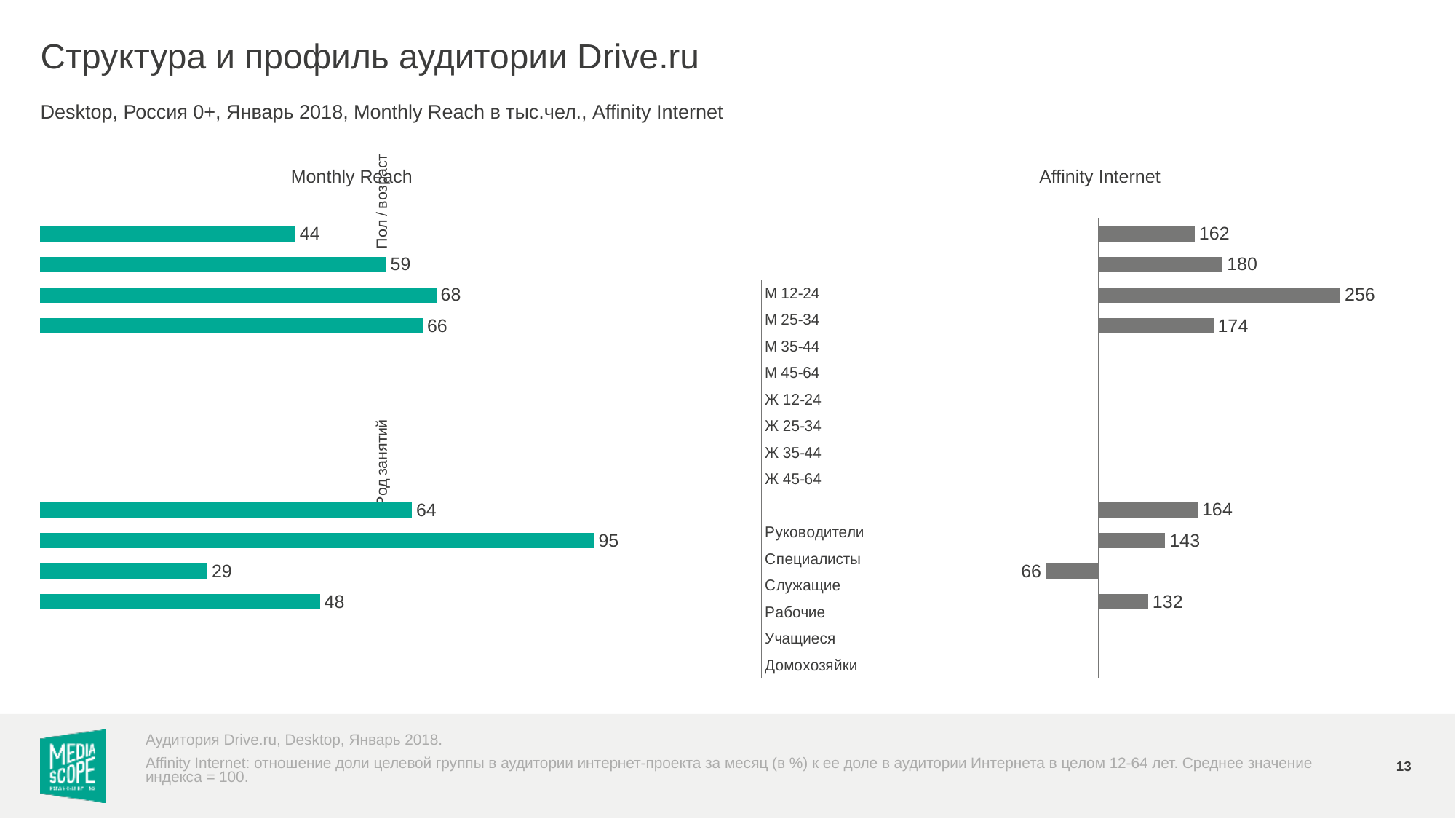
In the Monthly Reach chart, is the topmost bar larger or smaller than the second bar from the top? smaller What kind of chart is the Monthly Reach chart on the left? bar chart How many bars are plotted in the Affinity Internet chart? 8 In the Monthly Reach chart, what is the lowest value shown? 29 In the Affinity Internet chart, what is the difference between the highest and lowest values? 190 How many bars are plotted in the Monthly Reach chart? 8 In the Monthly Reach chart, what is the highest value shown? 95 In the Affinity Internet chart, what is the lowest value shown? 66 In the Monthly Reach chart, what is the value of the topmost bar? 44 In the Affinity Internet chart, what is the value of the topmost bar? 162 In the Monthly Reach chart, what is the difference between the highest and lowest values? 66 In the Affinity Internet chart, what is the highest value shown? 256